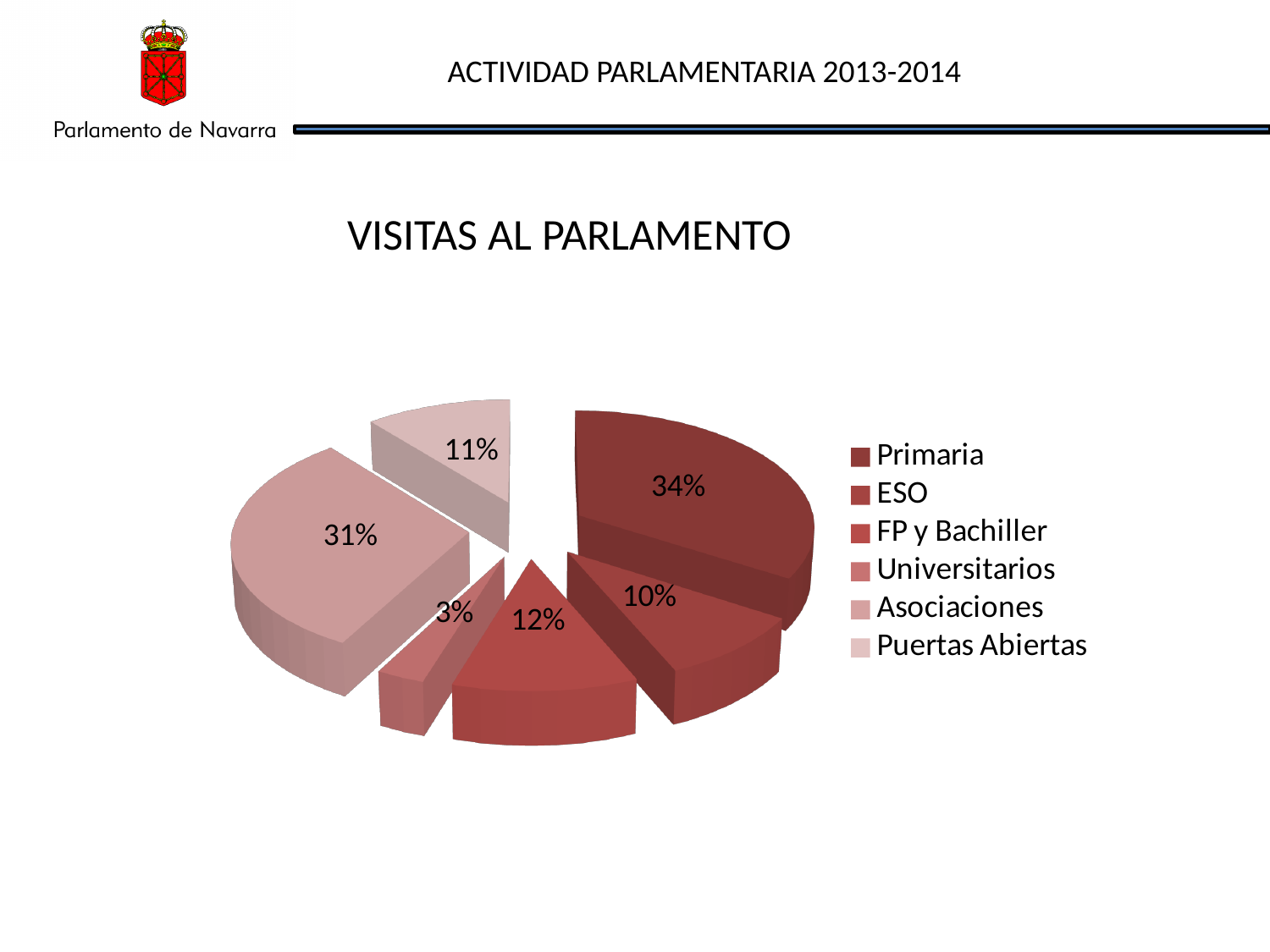
Which category has the largest slice of the pie? Primaria What percentage is shown for FP y Bachiller? 12% What share of the pie does Primaria represent? 34% What percentage is shown for Puertas Abiertas? 11% What kind of chart is shown on the slide? Pie chart What is the difference in percentage points between Primaria and Asociaciones? 3 Which category has the smallest slice of the pie? Universitarios What percentage is shown for Universitarios? 3% How many categories does the legend list? 6 Which is larger, the share for ESO or the share for FP y Bachiller? FP y Bachiller What is the title of the chart? VISITAS AL PARLAMENTO What share of the pie does Asociaciones represent? 31%